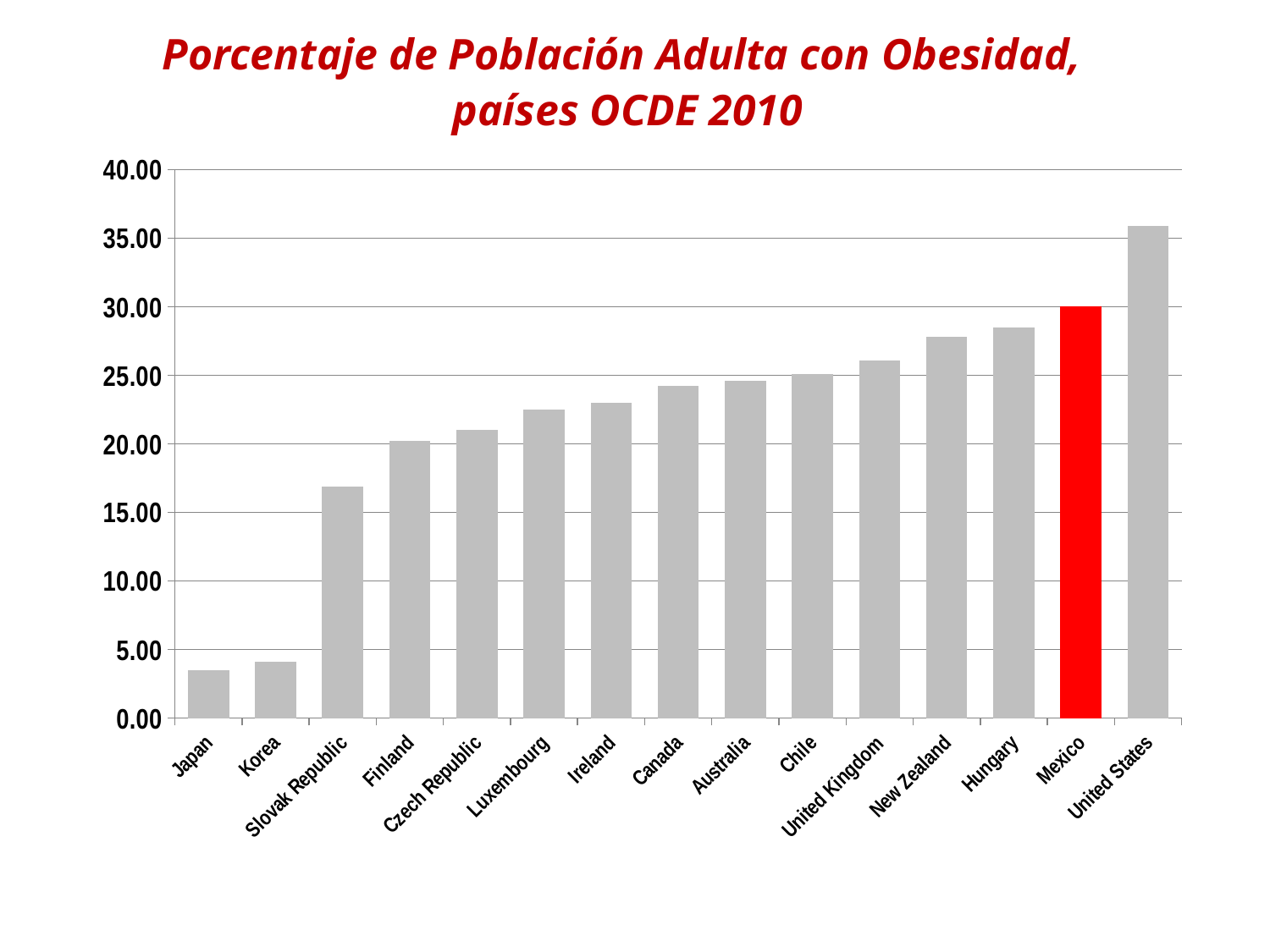
Which country has the highest percentage of adult population with obesity in the chart? United States Which country's bar is highlighted in red? Mexico Is the value for Slovak Republic greater or less than 15.00? greater Which has a higher value, Canada or Finland? Canada Do the values generally rise or fall moving from left to right along the x axis? rise What kind of chart is shown on the slide? bar chart Is the value for United States greater or less than 35.00? greater Which country has the lowest percentage of adult population with obesity in the chart? Japan Is the value for Japan greater or less than 5.00? less How many countries are shown on the x axis of the chart? 15